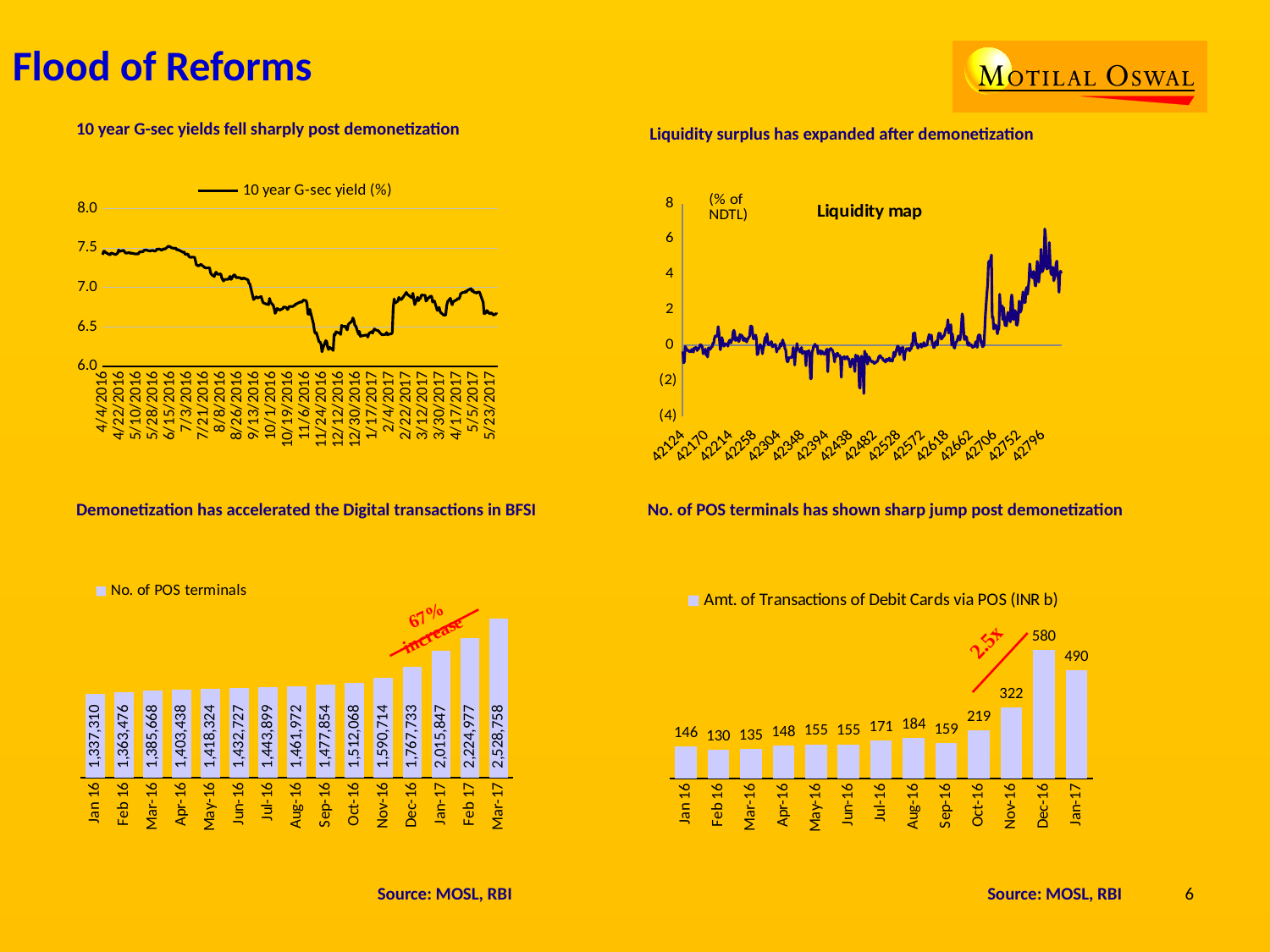
How many bars are in the bottom-right bar chart (Amt. of Transactions of Debit Cards via POS)? 13 How many bars are in the bottom-left bar chart (No. of POS terminals)? 15 In the bottom-right bar chart (Amt. of Transactions of Debit Cards via POS), which month has the highest value? Dec-16 In the bottom-right bar chart (Amt. of Transactions of Debit Cards via POS), which month has the lowest value? Feb 16 What is the title shown inside the top-right line chart? Liquidity map In the top-left chart (10 year G-sec yield), does the yield overall rise or fall from April 2016 to May 2017? fall What kind of chart is the top-left chart showing the 10 year G-sec yield? Line chart In the bottom-right bar chart (Amt. of Transactions of Debit Cards via POS), what is the difference between the Dec-16 and Nov-16 values? 258 In the bottom-right bar chart (Amt. of Transactions of Debit Cards via POS), what is the value for Dec-16? 580 In the top-left chart (10 year G-sec yield), is the value at 4/4/2016 greater or less than 7.0? greater In the bottom-left bar chart (No. of POS terminals), which is larger: the value for Dec-16 or the value for Jan-17? Jan-17 In the bottom-left bar chart (No. of POS terminals), what is the value for Mar-17? 2,528,758